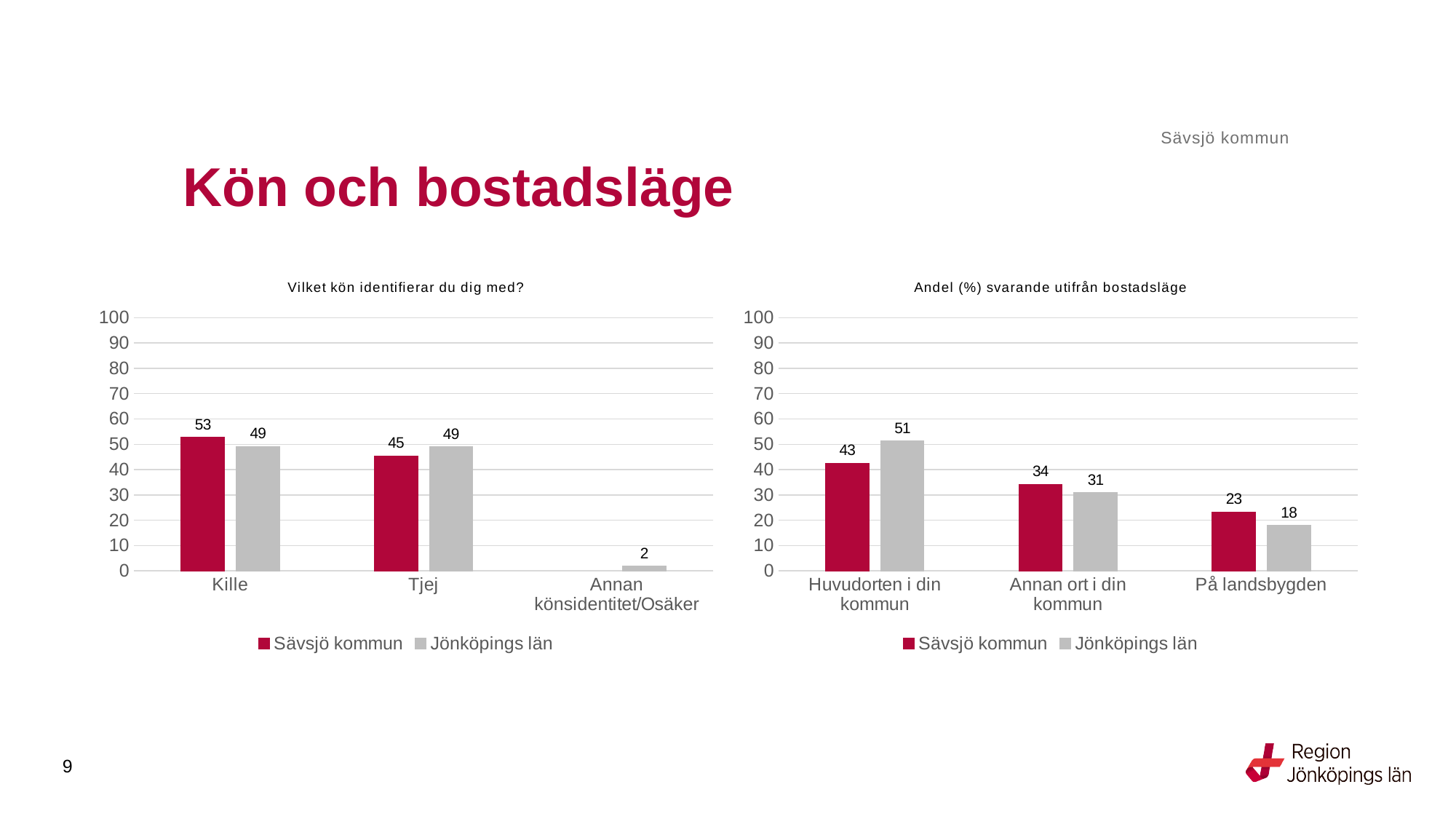
In the chart titled "Vilket kön identifierar du dig med?", how many series does the legend list? 2 In the chart titled "Andel (%) svarande utifrån bostadsläge", what is the value for Jönköpings län for Huvudorten i din kommun? 51 In the chart titled "Vilket kön identifierar du dig med?", what is the value for Jönköpings län for Annan könsidentitet/Osäker? 2 In the chart titled "Vilket kön identifierar du dig med?", which category has the highest value for Sävsjö kommun? Kille In the chart titled "Vilket kön identifierar du dig med?", what is the difference between Sävsjö kommun and Jönköpings län for Kille? 4 In the chart titled "Andel (%) svarande utifrån bostadsläge", how many categories are shown on the x axis? 3 In the chart titled "Vilket kön identifierar du dig med?", what is the value for Sävsjö kommun for Kille? 53 In the chart titled "Andel (%) svarande utifrån bostadsläge", what is the value for Sävsjö kommun for På landsbygden? 23 In the chart titled "Andel (%) svarande utifrån bostadsläge", which is larger for Annan ort i din kommun: Sävsjö kommun or Jönköpings län? Sävsjö kommun In the chart titled "Andel (%) svarande utifrån bostadsläge", which category has the lowest value for Jönköpings län? På landsbygden In the chart titled "Vilket kön identifierar du dig med?", what is the value for Jönköpings län for Tjej? 49 In the chart titled "Andel (%) svarande utifrån bostadsläge", what is the difference between Jönköpings län and Sävsjö kommun for Huvudorten i din kommun? 8